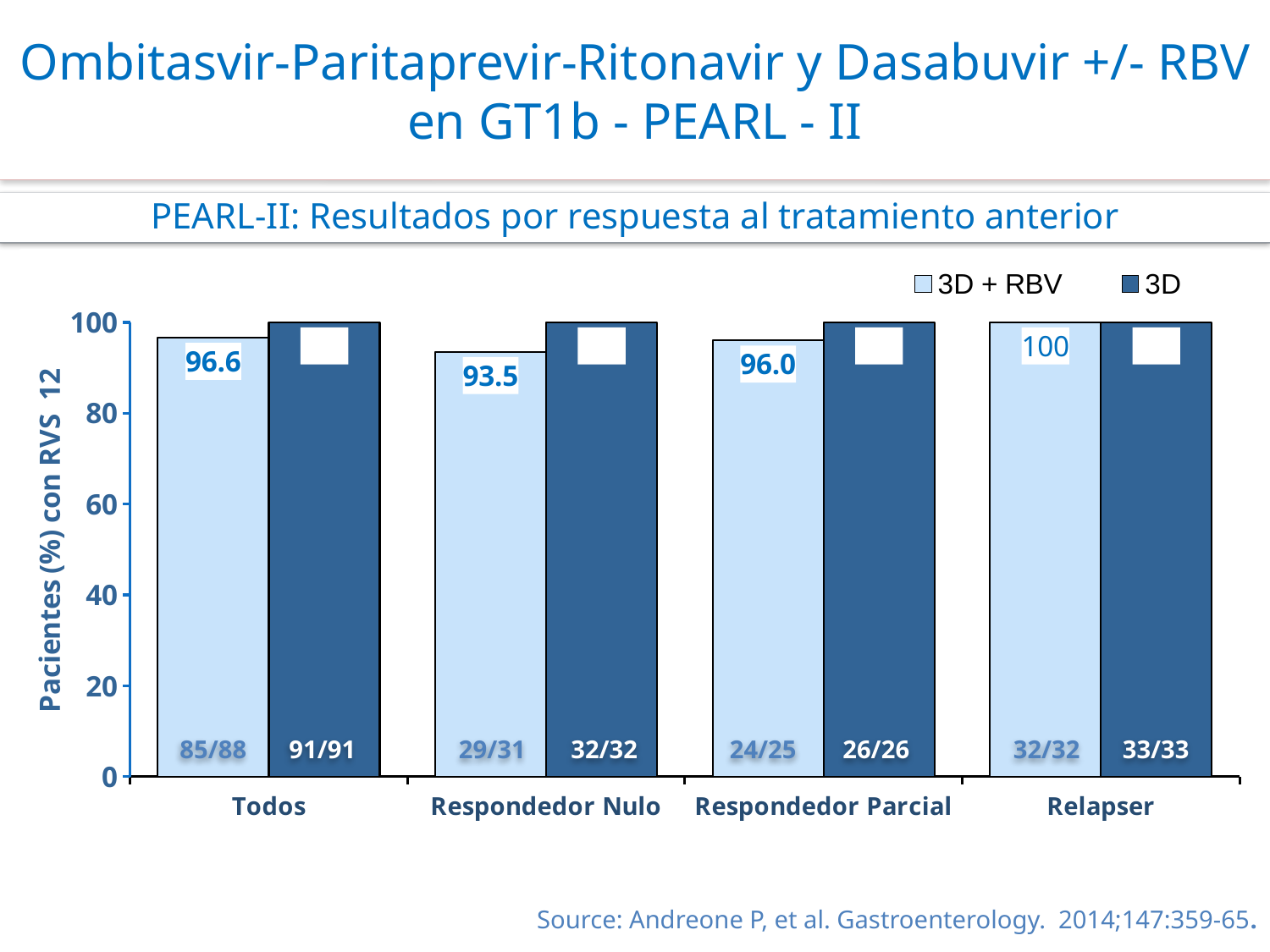
What is the difference between the 3D + RBV values for Todos and Respondedor Nulo? 3.1 What is the value for 3D + RBV in the Respondedor Nulo category? 93.5 What is the value for 3D + RBV in the Todos category? 96.6 How many categories are shown on the x axis? 4 What is the label of the y axis? Pacientes (%) con RVS 12 How many series does the legend list? 2 Which category has the lowest value for the 3D + RBV series? Respondedor Nulo What kind of chart is shown on the slide? bar chart What is the value for 3D + RBV in the Relapser category? 100 Is the value for the 3D bar in the Todos category greater or less than 80? greater Which is larger for 3D + RBV: Todos or Respondedor Parcial? Todos What patient fraction is printed on the 3D bar for Todos? 91/91